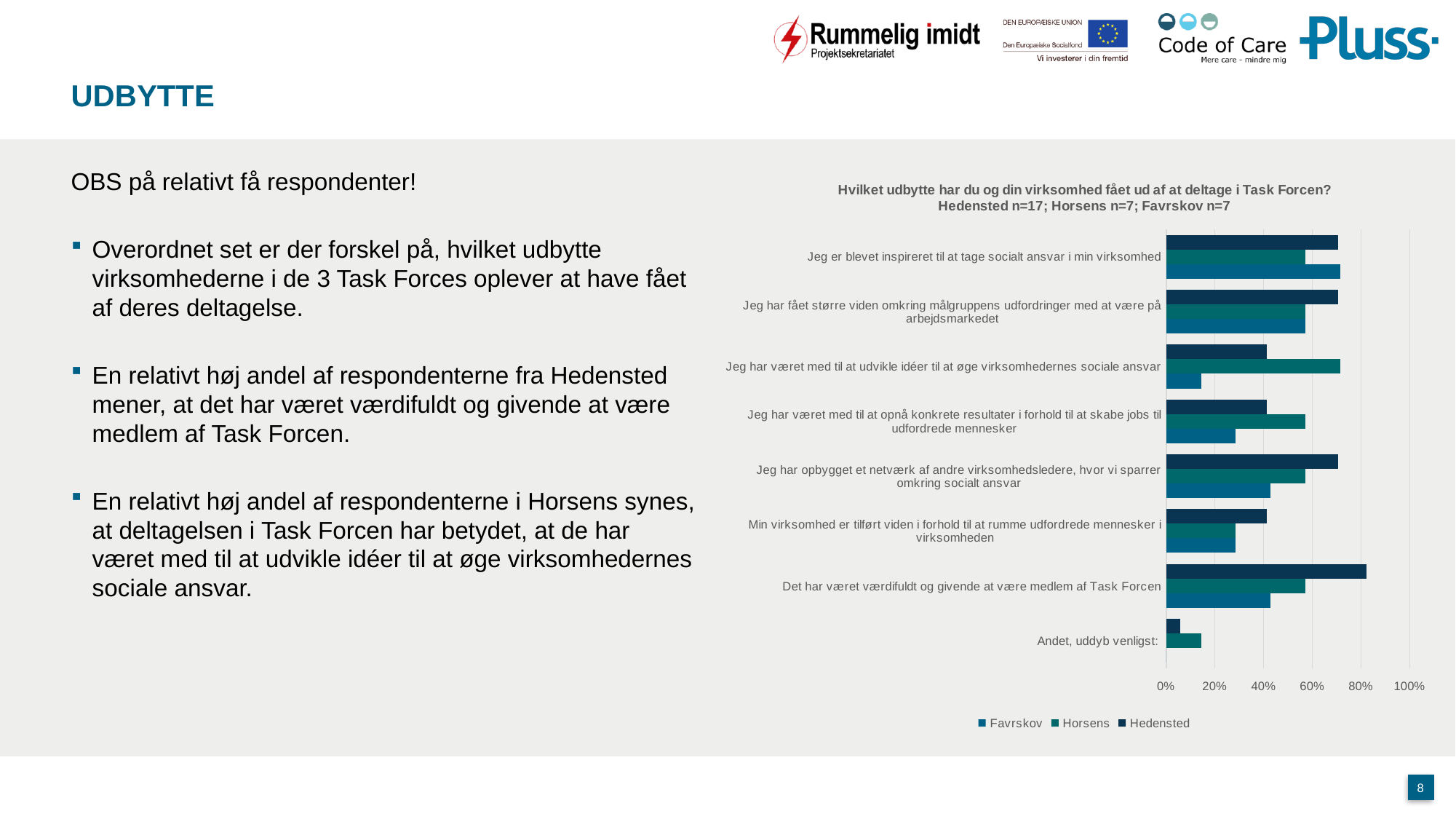
Is the Hedensted value for 'Min virksomhed er tilført viden i forhold til at rumme udfordrede mennesker i virksomheden' greater or less than 60%? less For 'Andet, uddyb venligst:', which is larger: the Horsens value or the Hedensted value? Horsens Which series does the legend list: name them in order. Favrskov, Horsens, Hedensted Is the Horsens value for 'Jeg har været med til at udvikle idéer til at øge virksomhedernes sociale ansvar' greater or less than 60%? greater Is the Favrskov value for 'Jeg har været med til at udvikle idéer til at øge virksomhedernes sociale ansvar' greater or less than 20%? less How many series does the chart legend list? 3 How many statement categories are plotted on the chart? 8 What kind of chart is shown on the slide? bar chart Which series has the highest value for 'Det har været værdifuldt og givende at være medlem af Task Forcen'? Hedensted Which category has the lowest Hedensted value? Andet, uddyb venligst: Which series has the highest value for 'Jeg har været med til at udvikle idéer til at øge virksomhedernes sociale ansvar'? Horsens